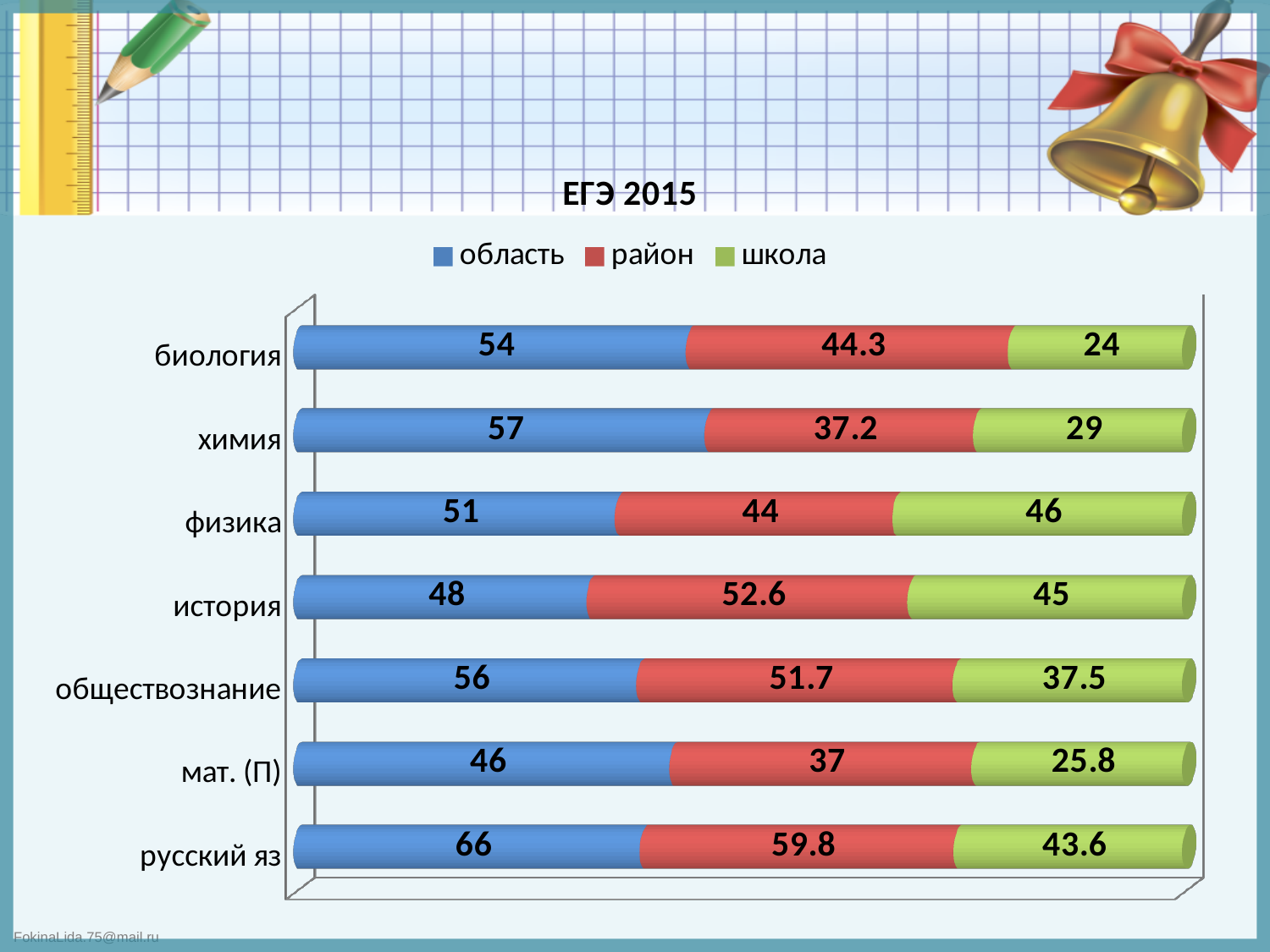
What is the title of the chart? ЕГЭ 2015 What is the value for область for русский яз? 66 Which subject has the lowest value for школа? биология What is the difference between the область and школа values for биология? 30 How many series does the legend list? 3 What kind of chart is shown on the slide? stacked bar chart Which subject has the highest value for область? русский яз What is the value for школа for мат. (П)? 25.8 What is the value for район for химия? 37.2 What is the value for район for история? 52.6 For история, which is larger: the область value or the район value? район How many subjects are shown on the chart? 7